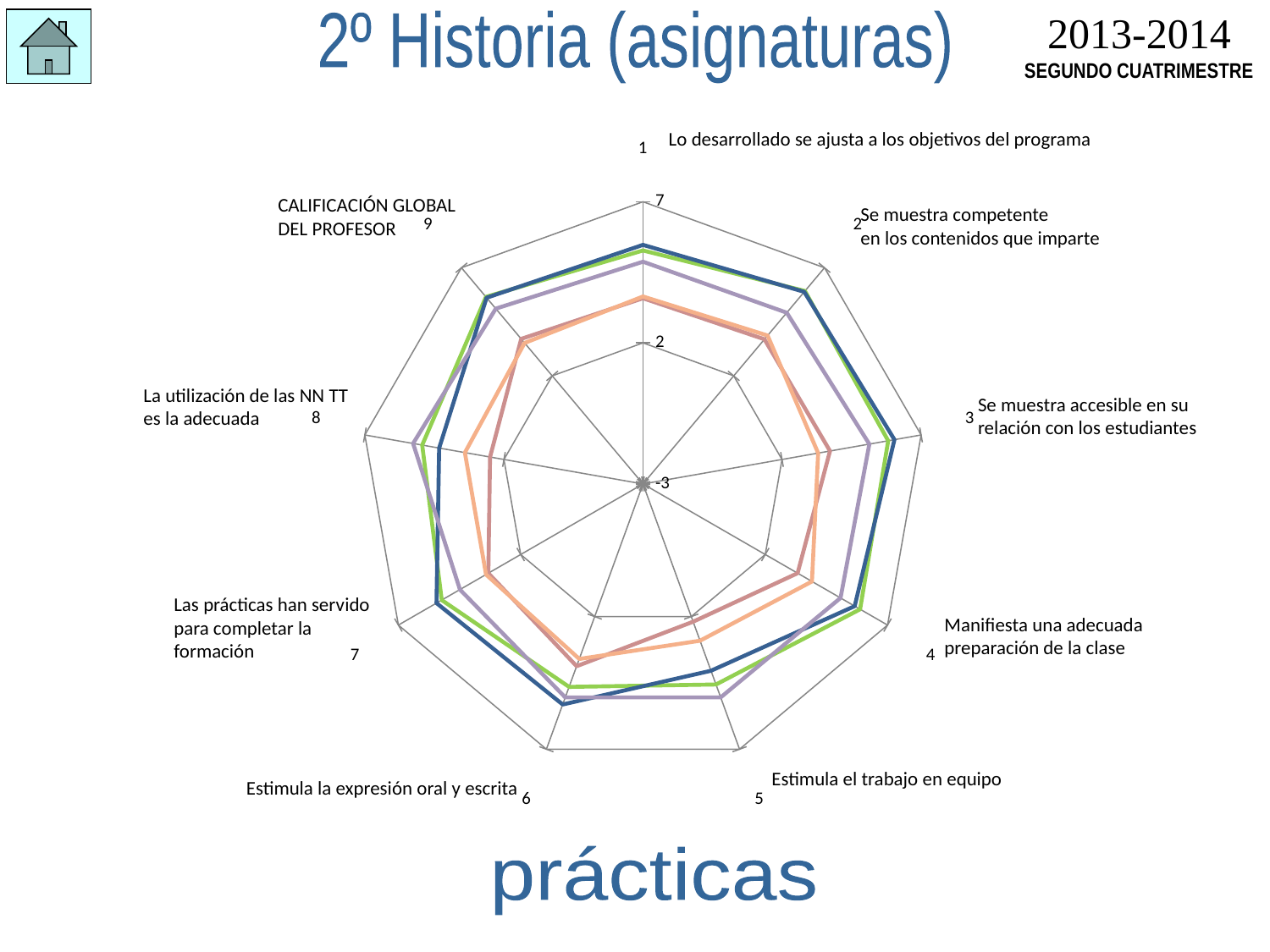
Is the value of the purple line for 'Manifiesta una adecuada preparación de la clase' greater or less than 2? greater How many categories (axes) does the radar chart have? 9 What is the highest value marked on the chart's radial axis? 7 Is the value of the orange line for 'Estimula el trabajo en equipo' greater or less than 7? less Is the value of the dark blue line for 'Lo desarrollado se ajusta a los objetivos del programa' greater or less than 2? greater What kind of chart is shown on the slide? radar chart